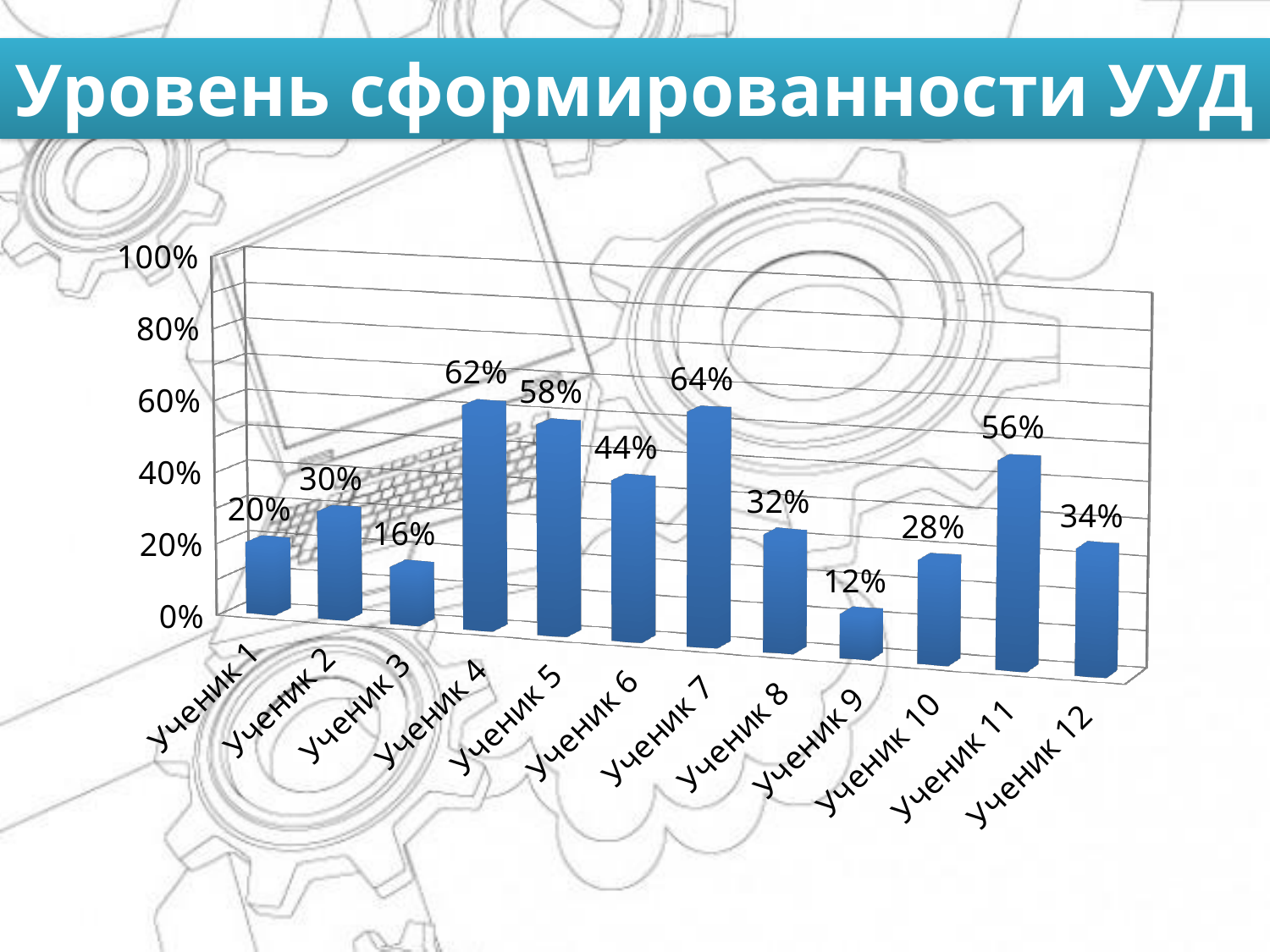
What is the difference between the values for Ученик 1 and Ученик 3? 4% Which is larger, the value for Ученик 2 or the value for Ученик 12? Ученик 12 What kind of chart is shown on the slide? bar chart Which category has the lowest value? Ученик 9 Which category has the highest value? Ученик 7 How many categories are shown on the x axis? 12 Is the value for Ученик 6 greater or less than 40%? greater What is the value for Ученик 11? 56% What is the value for Ученик 4? 62% What is the value for Ученик 9? 12% What is the title of the slide? Уровень сформированности УУД What is the difference between the values for Ученик 7 and Ученик 5? 6%